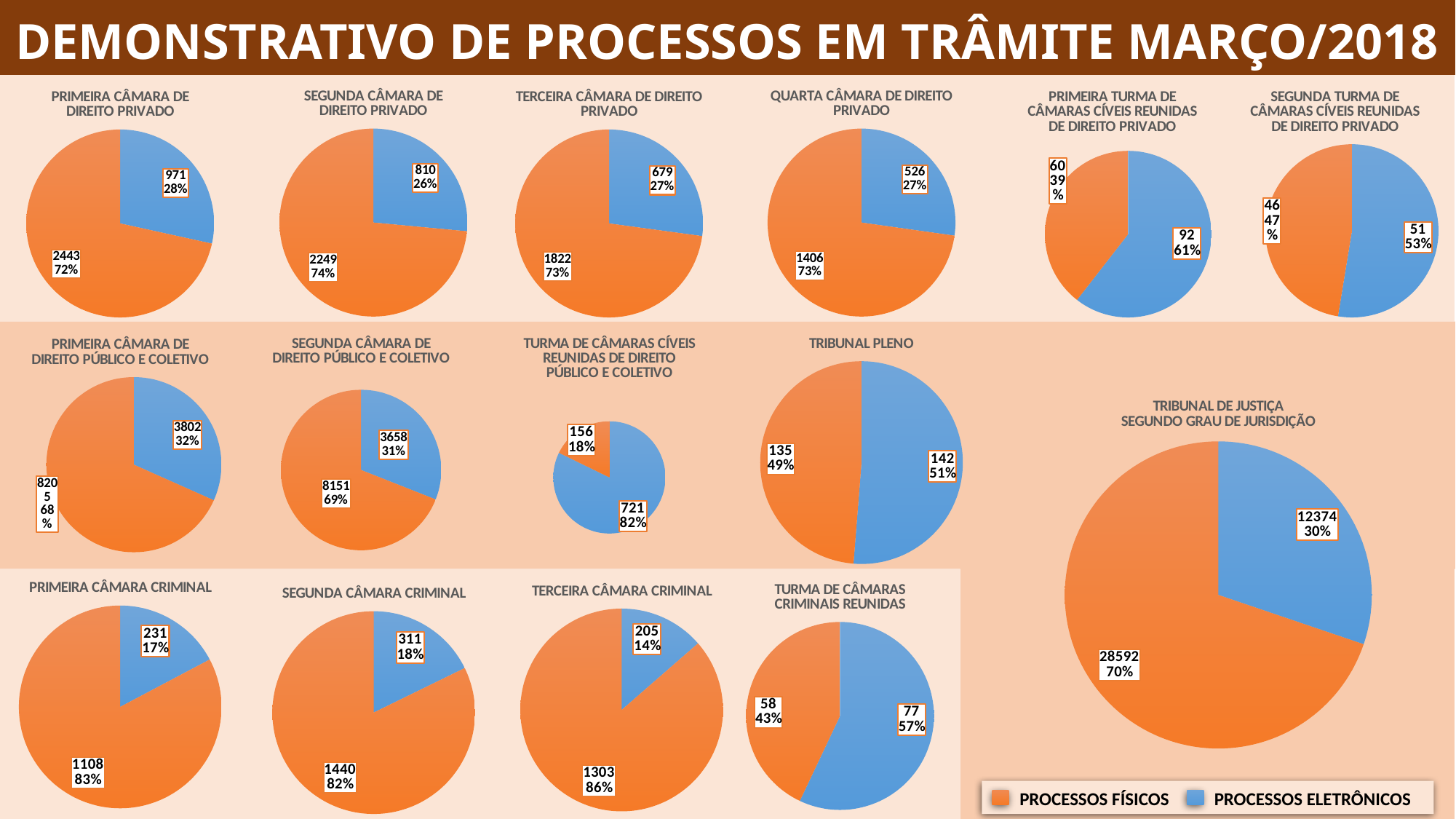
In the TRIBUNAL PLENO chart, what is the difference between PROCESSOS ELETRÔNICOS and PROCESSOS FÍSICOS? 7 What kind of chart is used for TRIBUNAL PLENO? Pie chart In the PRIMEIRA TURMA DE CÂMARAS CÍVEIS REUNIDAS DE DIREITO PRIVADO chart, what is the value for PROCESSOS ELETRÔNICOS? 92 How many series does the legend at the bottom right list? 2 In the SEGUNDA CÂMARA DE DIREITO PÚBLICO E COLETIVO chart, what is the value for PROCESSOS FÍSICOS? 8151 In the TRIBUNAL DE JUSTIÇA SEGUNDO GRAU DE JURISDIÇÃO chart, what share of the pie is PROCESSOS ELETRÔNICOS? 30% In the PRIMEIRA CÂMARA DE DIREITO PRIVADO chart, what is the value for PROCESSOS ELETRÔNICOS? 971 In the TERCEIRA CÂMARA CRIMINAL chart, what percentage is PROCESSOS FÍSICOS? 86% In the SEGUNDA CÂMARA CRIMINAL chart, what is the total of the two slices? 1751 In the TURMA DE CÂMARAS CÍVEIS REUNIDAS DE DIREITO PÚBLICO E COLETIVO chart, which slice is larger, PROCESSOS FÍSICOS or PROCESSOS ELETRÔNICOS? PROCESSOS ELETRÔNICOS In the TRIBUNAL DE JUSTIÇA SEGUNDO GRAU DE JURISDIÇÃO chart, what is the value for PROCESSOS FÍSICOS? 28592 Which colour represents PROCESSOS ELETRÔNICOS in the legend? Blue